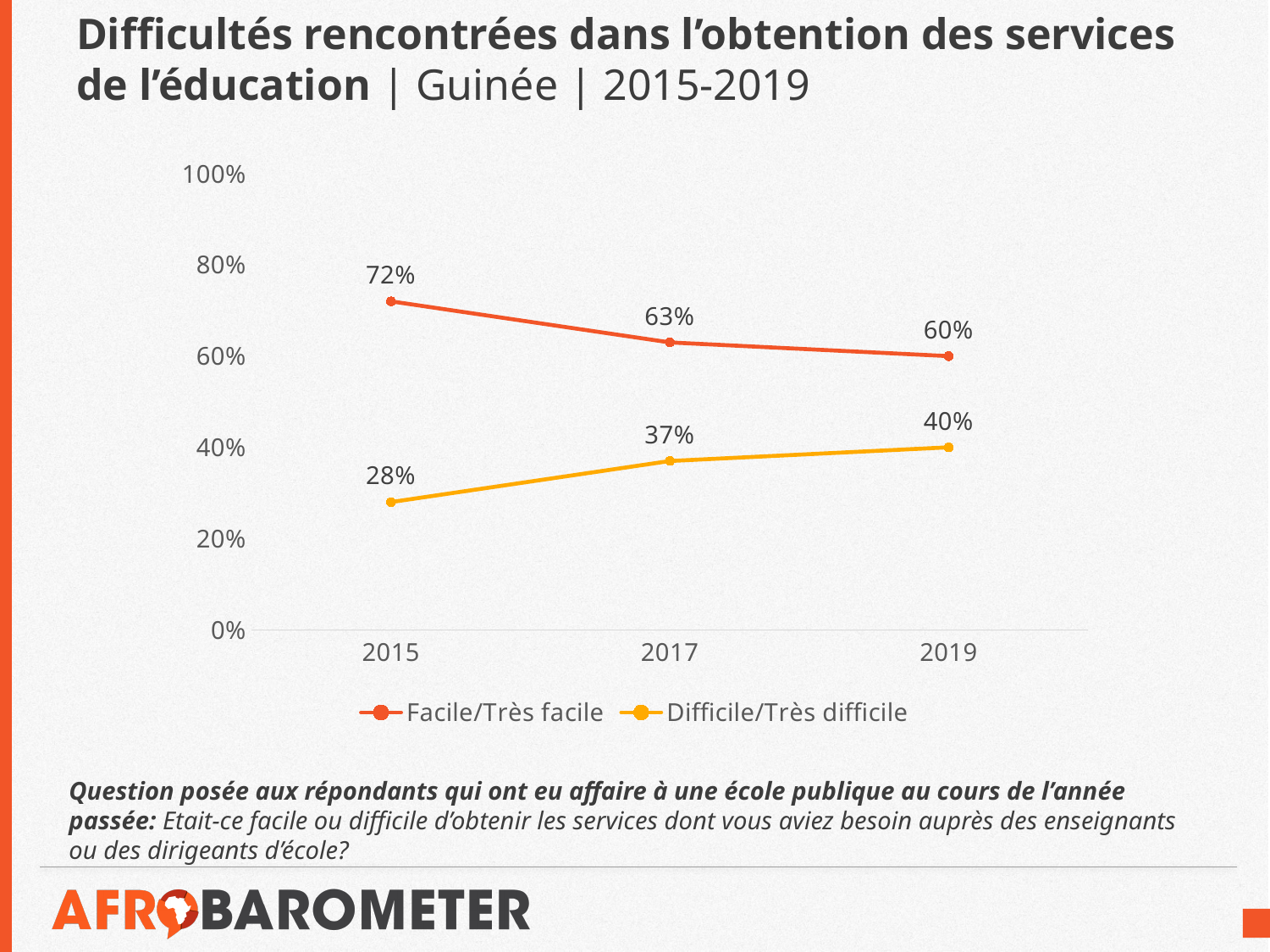
How many series does the legend list? 2 What kind of chart is shown on the slide? Line chart Does the Facile/Très facile line rise or fall from 2015 to 2019? Fall In which year is the Difficile/Très difficile value lowest? 2015 How many years are plotted on the x axis? 3 What is the value for Difficile/Très difficile in 2019? 40% What is the value for Facile/Très facile in 2015? 72% In which year is the Facile/Très facile value highest? 2015 Which is larger in 2017: Facile/Très facile or Difficile/Très difficile? Facile/Très facile What is the value for Facile/Très facile in 2017? 63% What is the difference between the Facile/Très facile and Difficile/Très difficile values in 2019? 20% By how much did the Difficile/Très difficile value change from 2015 to 2019? 12%